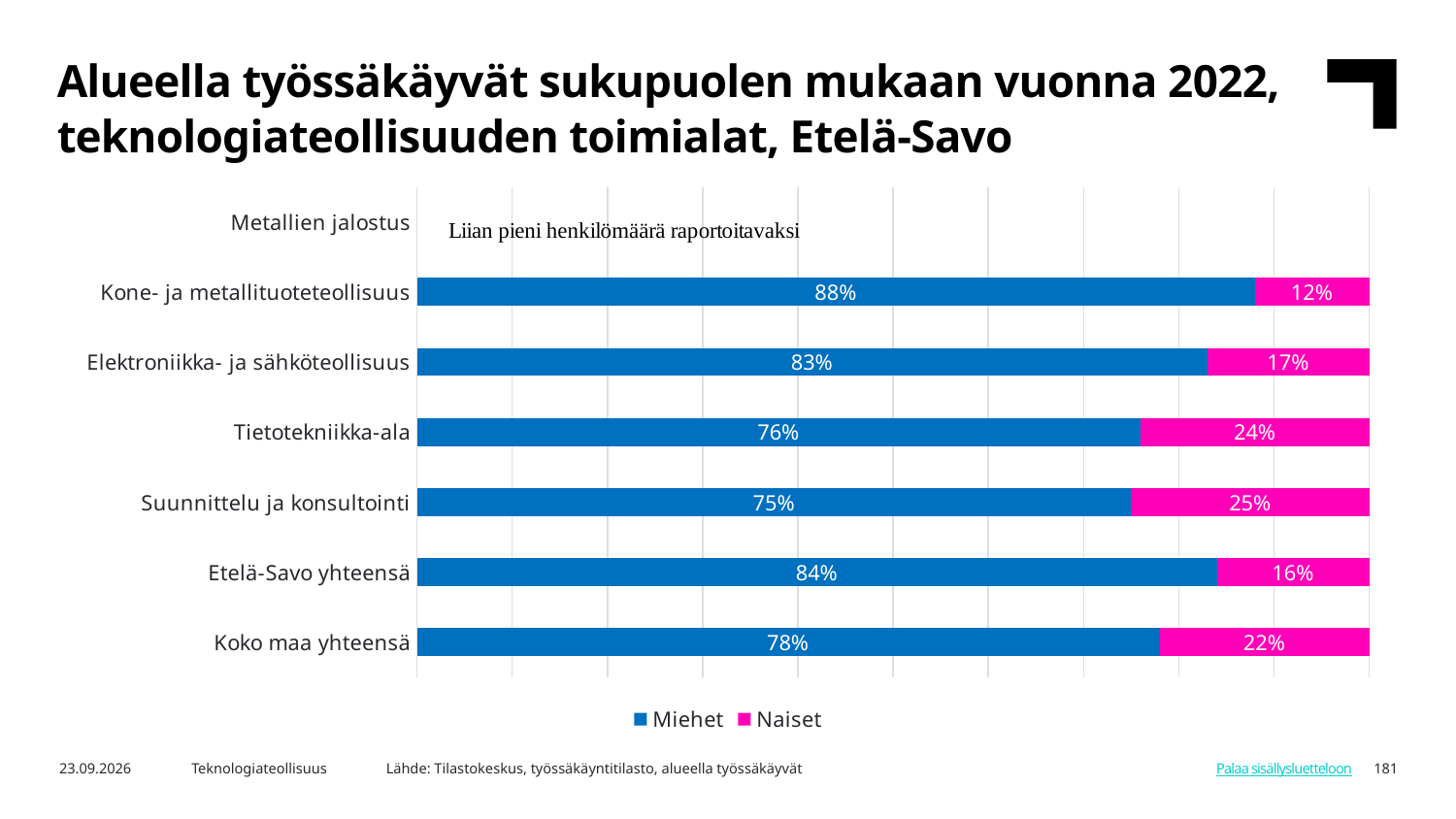
What is the Naiset share for Koko maa yhteensä? 22% Which is larger: the Naiset share for Elektroniikka- ja sähköteollisuus or for Etelä-Savo yhteensä? Elektroniikka- ja sähköteollisuus What is the difference between the Miehet share for Kone- ja metallituoteteollisuus and for Suunnittelu ja konsultointi? 13% What is the Miehet share for Kone- ja metallituoteteollisuus? 88% What is the Naiset share for Tietotekniikka-ala? 24% What kind of chart is shown on the slide? Bar chart What is the Miehet share for Etelä-Savo yhteensä? 84% What is the total of the stacked bar for Tietotekniikka-ala? 100% Which category has the highest Naiset share? Suunnittelu ja konsultointi Which category has the lowest Naiset share? Kone- ja metallituoteteollisuus How many series does the legend list? 2 What text is shown instead of a bar for Metallien jalostus? Liian pieni henkilömäärä raportoitavaksi